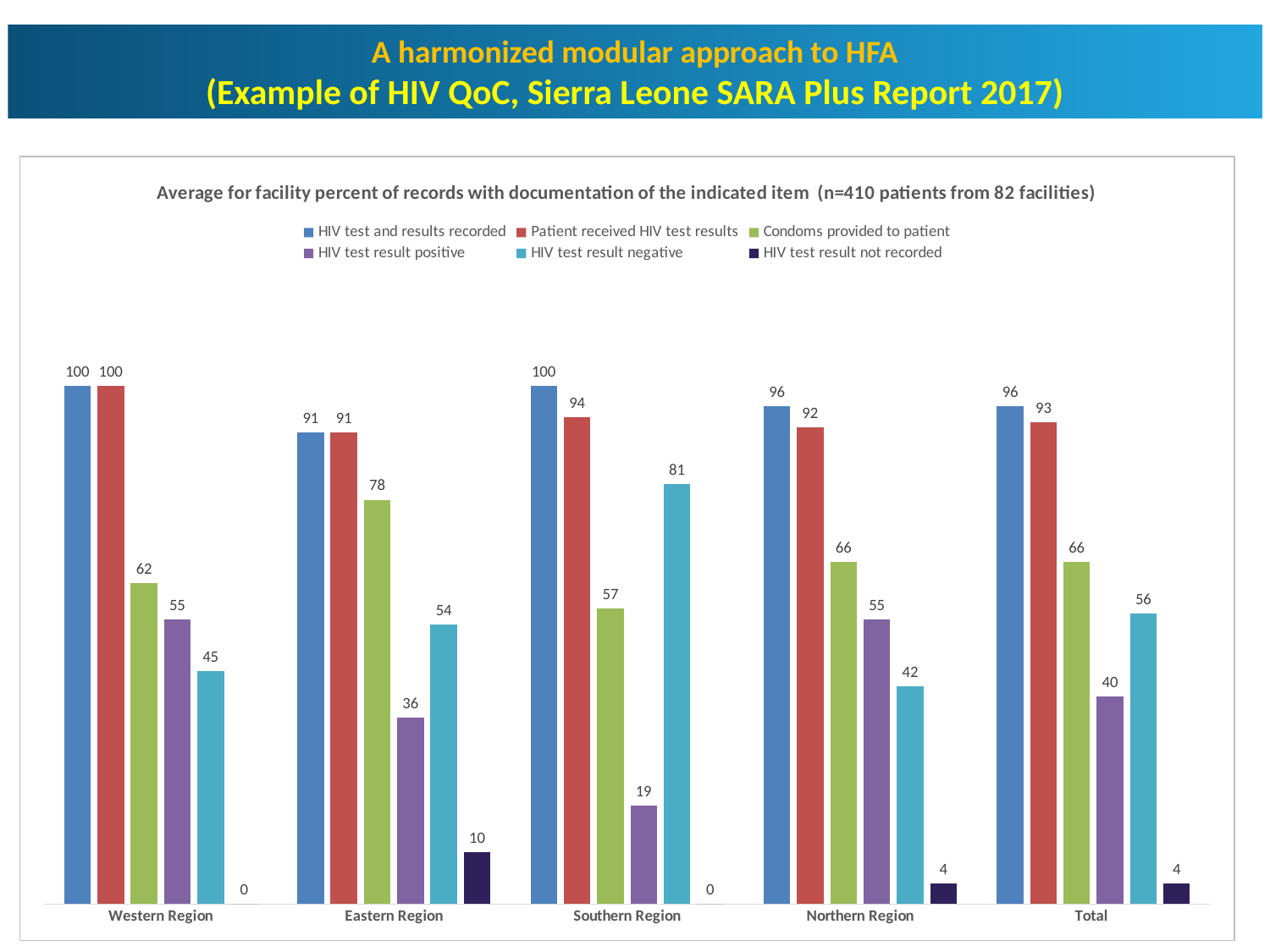
What is the value for 'HIV test result not recorded' in the Northern Region? 4 What is the value for 'Condoms provided to patient' in the Eastern Region? 78 What is the difference between 'HIV test and results recorded' and 'Patient received HIV test results' in the Southern Region? 6 What is the value for 'HIV test result negative' in the Southern Region? 81 What is the value of n stated in the chart title? 410 patients from 82 facilities Which is larger in the Western Region: 'HIV test result positive' or 'HIV test result negative'? HIV test result positive How many categories are shown on the x axis? 5 What is the value for 'HIV test result positive' in the Total category? 40 Which region has the lowest value for 'HIV test result positive'? Southern Region What kind of chart is shown on the slide? Bar chart Which region has the highest value for 'HIV test result negative'? Southern Region How many series does the legend list? 6